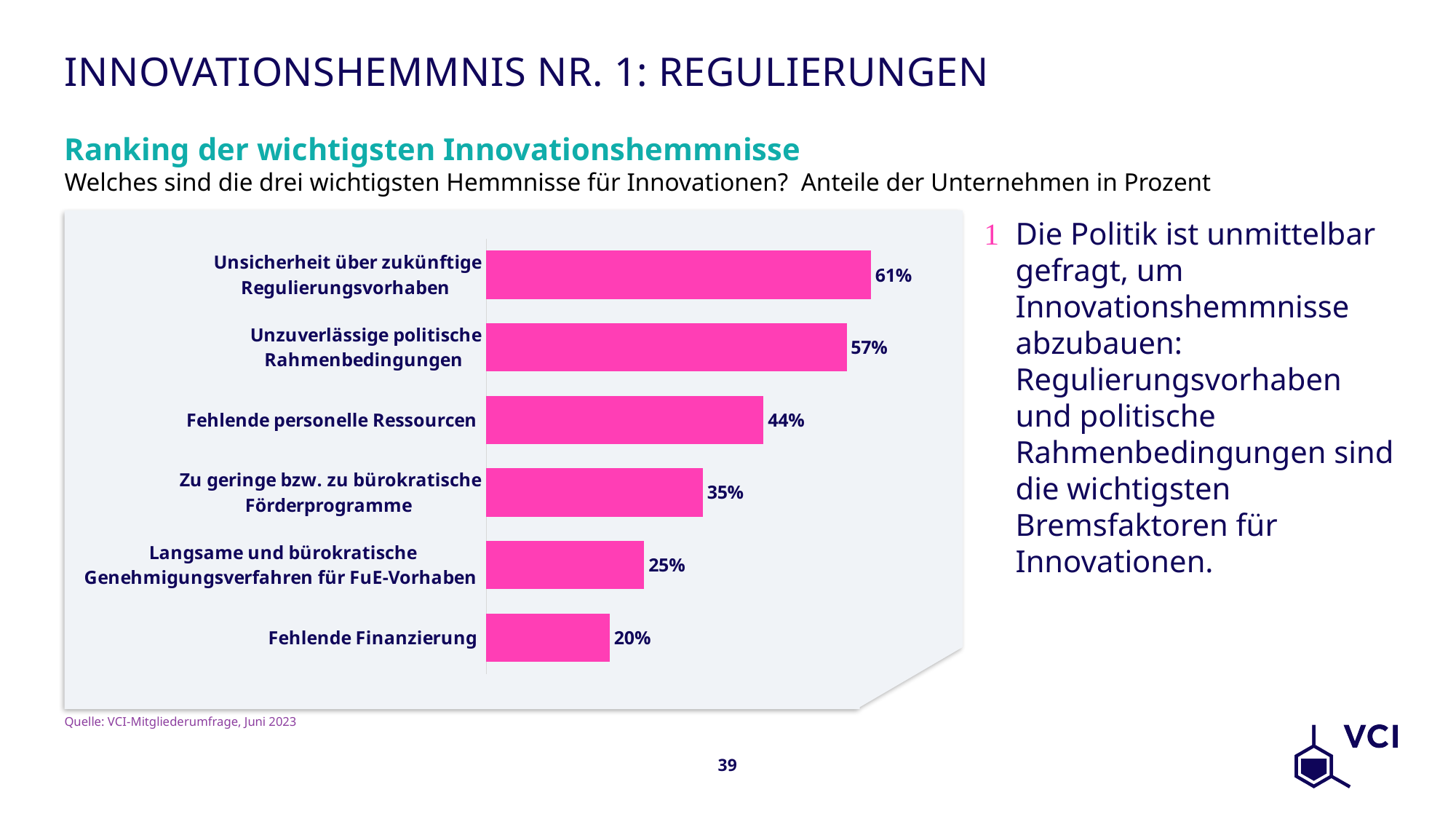
What is the value shown for 'Langsame und bürokratische Genehmigungsverfahren für FuE-Vorhaben'? 25% Which has a larger value: 'Zu geringe bzw. zu bürokratische Förderprogramme' or 'Langsame und bürokratische Genehmigungsverfahren für FuE-Vorhaben'? Zu geringe bzw. zu bürokratische Förderprogramme What is the difference between the values for 'Unsicherheit über zukünftige Regulierungsvorhaben' and 'Unzuverlässige politische Rahmenbedingungen'? 4 percentage points What is the value shown for 'Fehlende personelle Ressourcen'? 44% What kind of chart is shown on the slide? Bar chart Which category has the lowest value in the chart? Fehlende Finanzierung What is the title of the chart? Ranking der wichtigsten Innovationshemmnisse What percentage of companies named 'Unsicherheit über zukünftige Regulierungsvorhaben' as an innovation obstacle? 61% How many categories are shown in the chart? 6 What is the difference between the values for 'Fehlende personelle Ressourcen' and 'Fehlende Finanzierung'? 24 percentage points What colour are the bars in the chart? Pink Which category has the highest value in the chart? Unsicherheit über zukünftige Regulierungsvorhaben